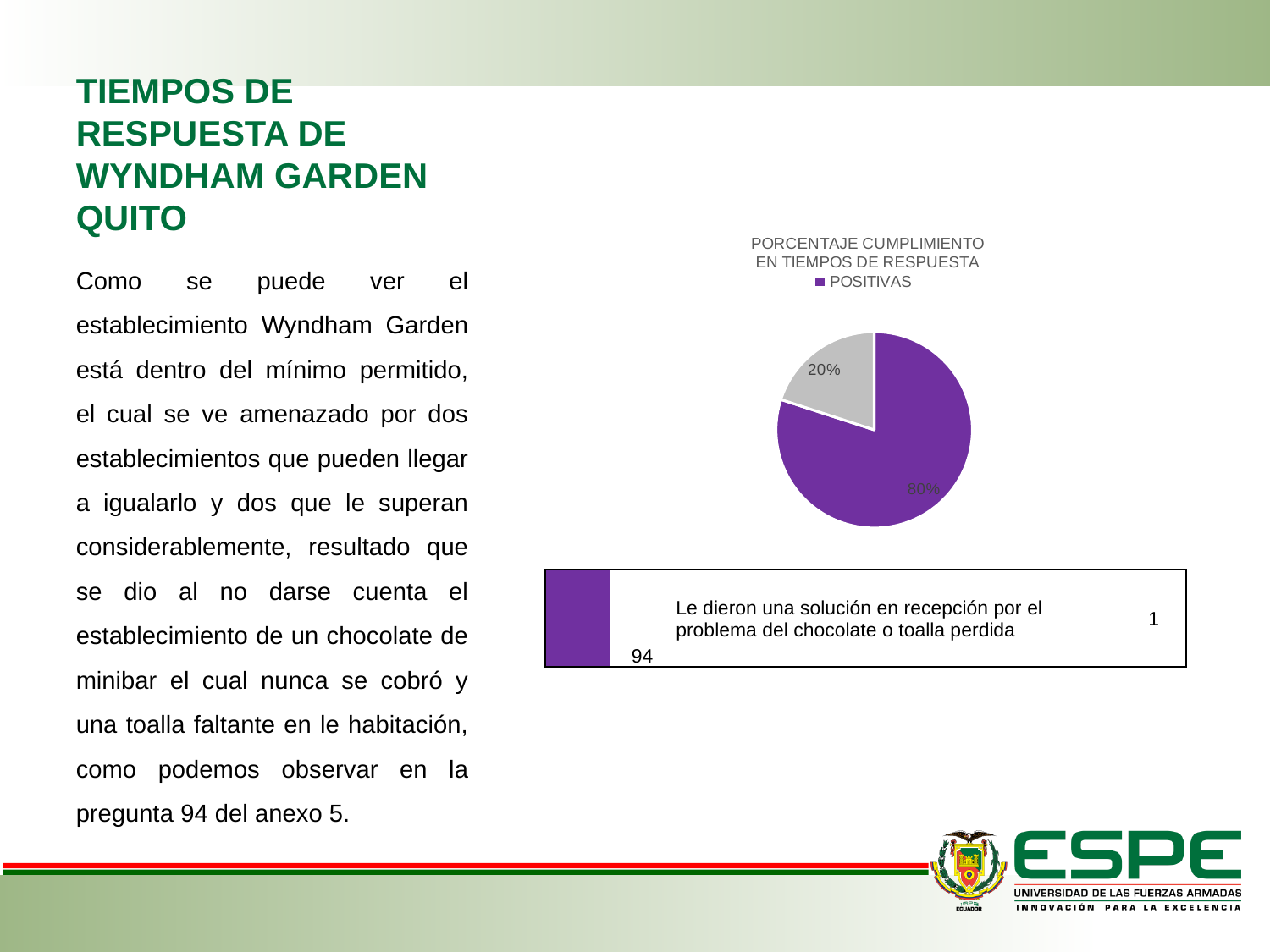
How many entries does the legend of the pie chart list? 1 What is the difference in percentage points between the purple slice and the gray slice? 60 percentage points What kind of chart is shown on the slide? pie chart Is the purple slice or the gray slice larger in the pie chart? the purple slice What entry does the legend of the pie chart list? POSITIVAS Which slice of the pie chart is the largest? the purple (POSITIVAS) slice, 80% How many slices does the pie chart have? 2 What share of the pie does the purple (POSITIVAS) slice represent? 80% Which slice of the pie chart is the smallest? the gray slice, 20% What is the title of the pie chart? PORCENTAJE CUMPLIMIENTO EN TIEMPOS DE RESPUESTA What share of the pie does the gray slice represent? 20%